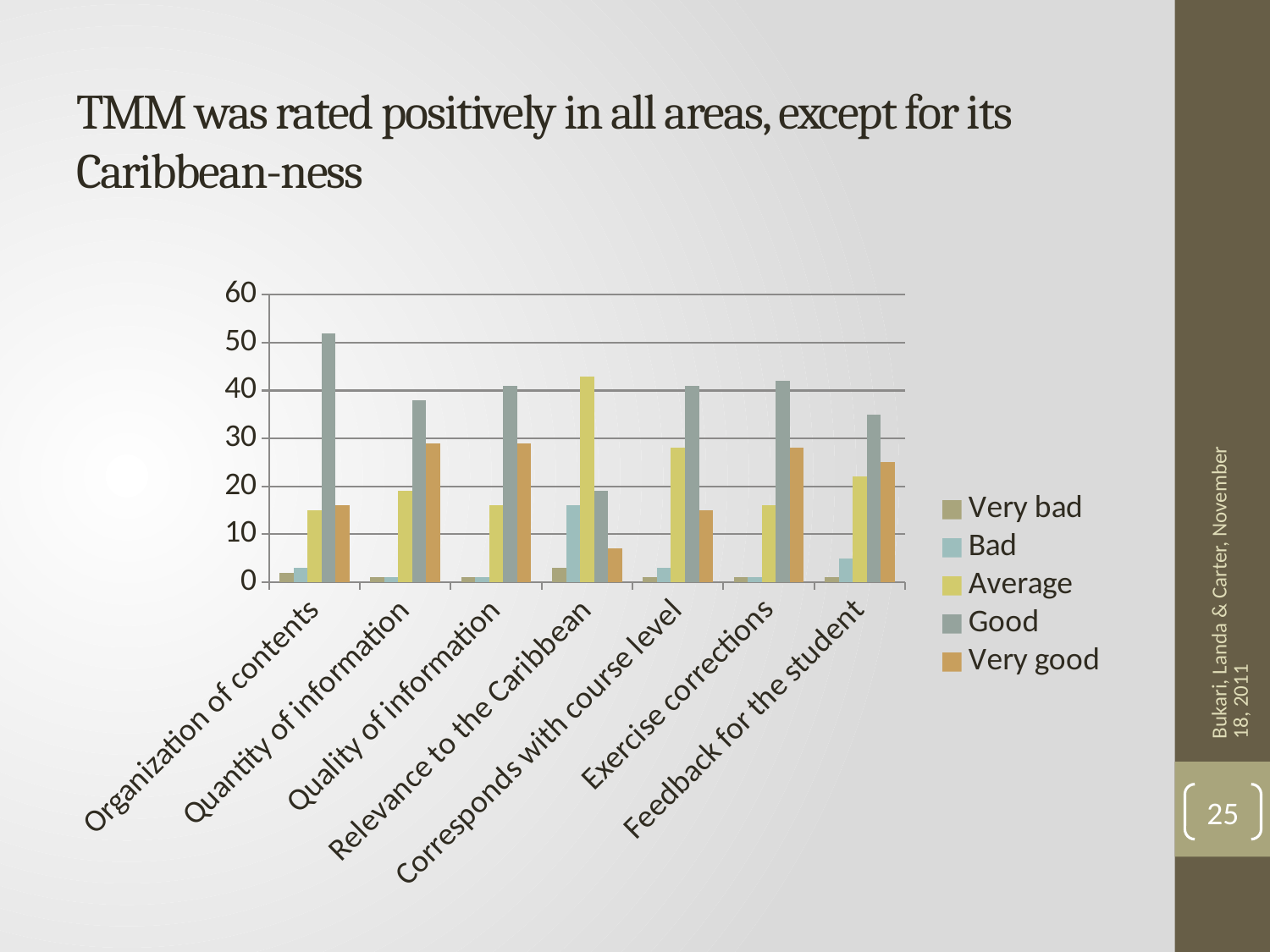
What kind of chart is shown on the slide? Bar chart Is the Average value for Relevance to the Caribbean greater or less than 40? greater How many series does the chart's legend list? 5 Which category has the highest value for the Good series? Organization of contents Is the Good value for Organization of contents greater or less than 50? greater Which category has the lowest value for the Good series? Relevance to the Caribbean For Relevance to the Caribbean, which is larger: the Average value or the Good value? Average For Quantity of information, which is larger: the Good value or the Very good value? Good How many categories are shown along the x axis of the chart? 7 What are the series names listed in the chart's legend? Very bad, Bad, Average, Good, Very good Is the Bad value for Relevance to the Caribbean greater or less than 10? greater